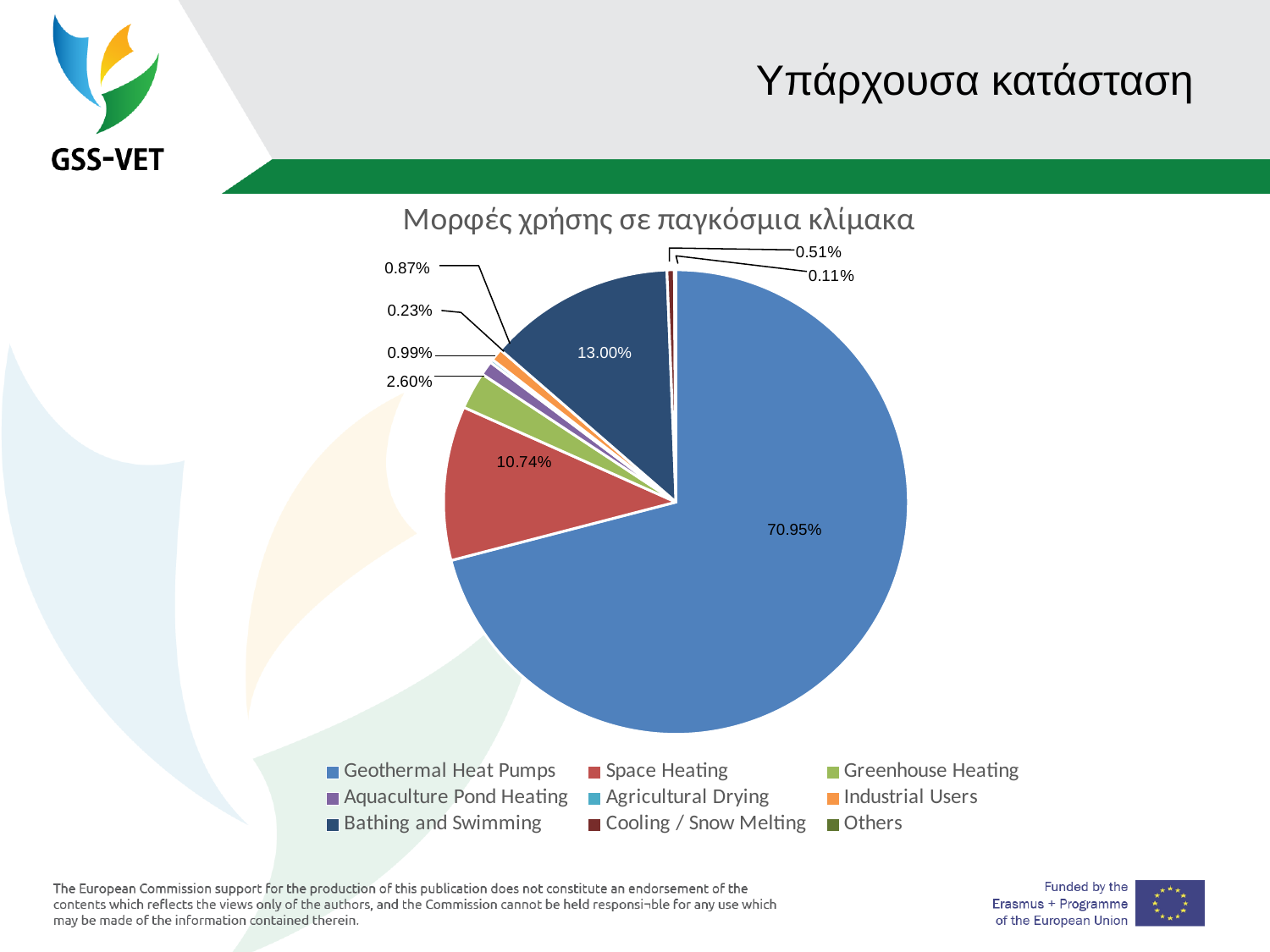
What is the title of the chart? Μορφές χρήσης σε παγκόσμια κλίμακα What share of the pie does Geothermal Heat Pumps have? 70.95% What share of the pie does Space Heating have? 10.74% What kind of chart is shown on the slide? pie chart What share of the pie does Bathing and Swimming have? 13.00% What colour is the slice for Geothermal Heat Pumps? blue What is the difference between the Geothermal Heat Pumps share and the Bathing and Swimming share? 57.95% Which category has the largest slice of the pie? Geothermal Heat Pumps Which is larger, the slice for Space Heating or the slice for Bathing and Swimming? Bathing and Swimming How many categories does the legend of the pie chart list? 9 Which category has the smallest slice of the pie? Others